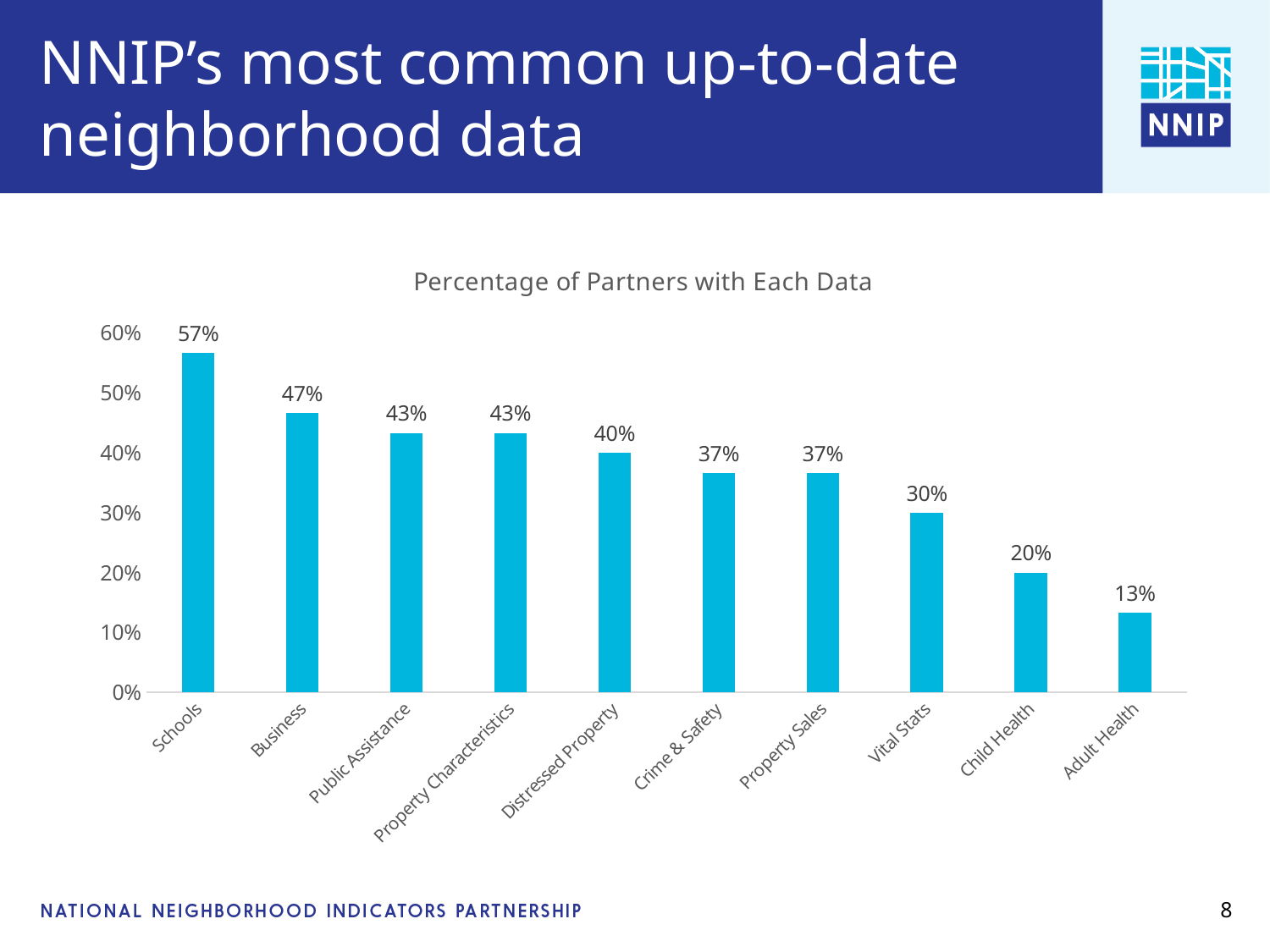
Which is larger, the value for Business or the value for Crime & Safety? Business Which category has the lowest percentage of partners? Adult Health What is the difference between the values for Schools and Business? 10% Is the value for Property Sales greater or less than 40%? less What percentage of partners have Child Health data? 20% How many categories are shown in the chart? 10 What is the title of the chart? Percentage of Partners with Each Data What kind of chart is shown on the slide? Bar chart What percentage of partners have Schools data? 57% What is the value for Vital Stats? 30% What is the difference between the values for Distressed Property and Adult Health? 27% Which category has the highest percentage of partners? Schools